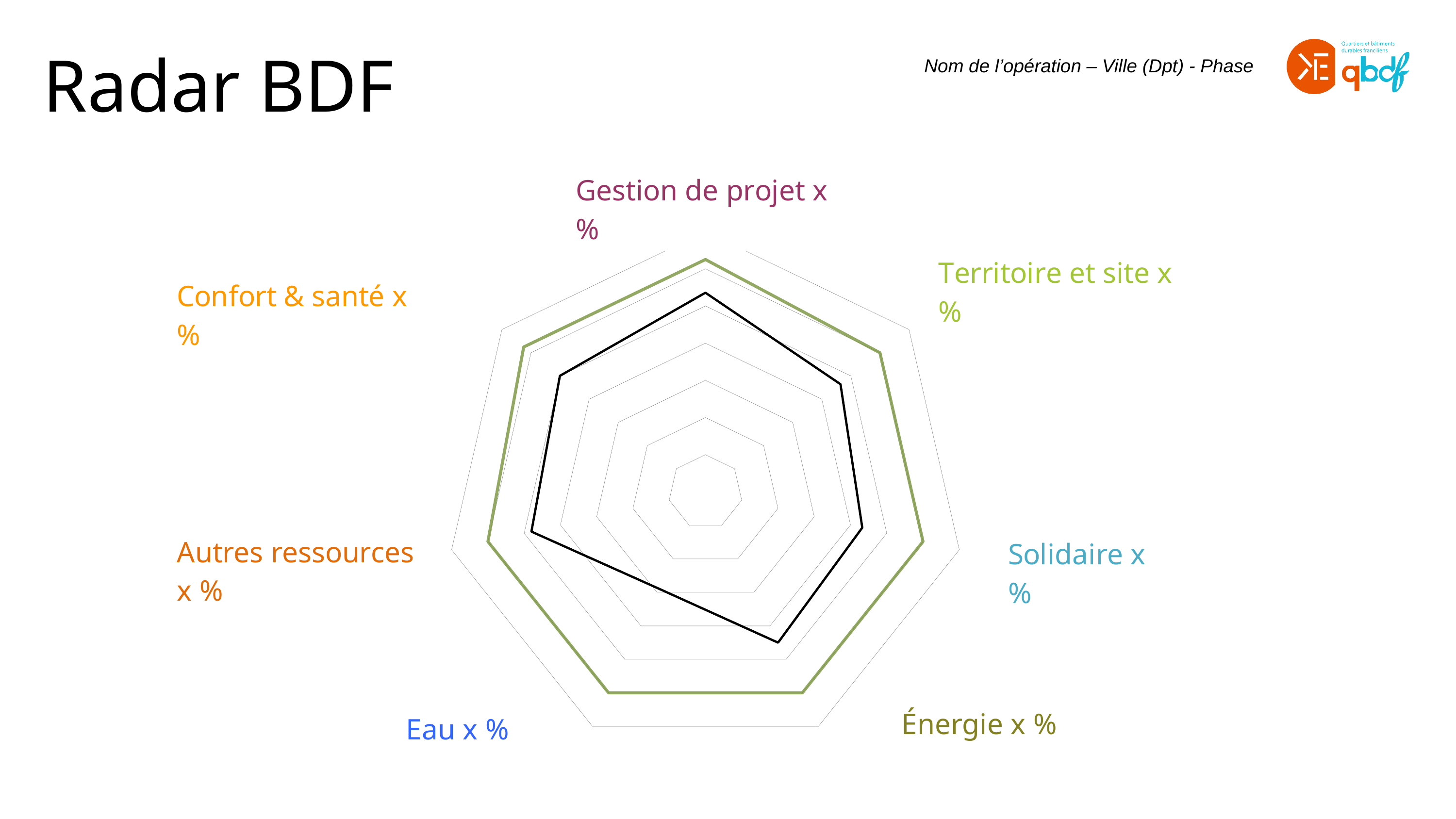
What kind of chart is shown on the slide? Radar chart Does the green line lie outside the black line on every axis of the radar chart? Yes How many plotted lines (series) appear on the radar chart? 2 For the black line, on which axis is the value lowest? Eau Which category label is shown at the top of the radar chart? Gestion de projet x % On the Eau axis, which line is closer to the centre, the green line or the black line? black On the Énergie axis, which line is further from the centre, the green line or the black line? green How many axes (categories) does the radar chart have? 7 What is the title of the slide containing the radar chart? Radar BDF